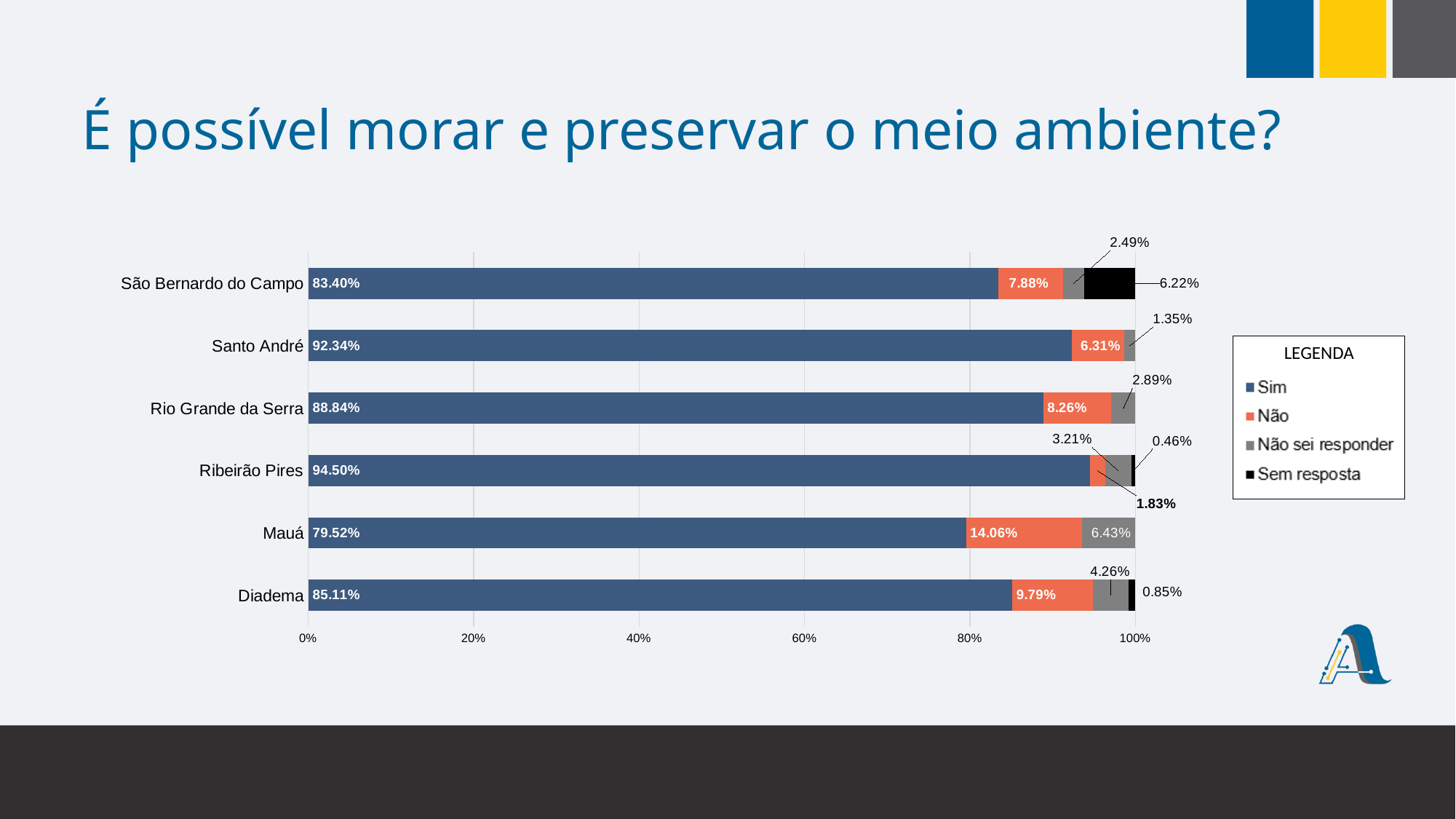
Which city has a larger "Não" value, Rio Grande da Serra or São Bernardo do Campo? Rio Grande da Serra What is the "Não" value for Mauá? 14.06% What is the title of the slide? É possível morar e preservar o meio ambiente? What type of chart is shown on the slide? Stacked bar chart What percentage of respondents in Santo André answered "Sim"? 92.34% How many series does the legend list? 4 What is the "Sem resposta" value for São Bernardo do Campo? 6.22% Which city has the lowest "Sim" percentage? Mauá Which city has the highest "Sim" percentage? Ribeirão Pires What is the difference between the "Não" values for Mauá and Diadema? 4.27% What is the "Não sei responder" value for Diadema? 4.26% How many cities are shown in the chart? 6